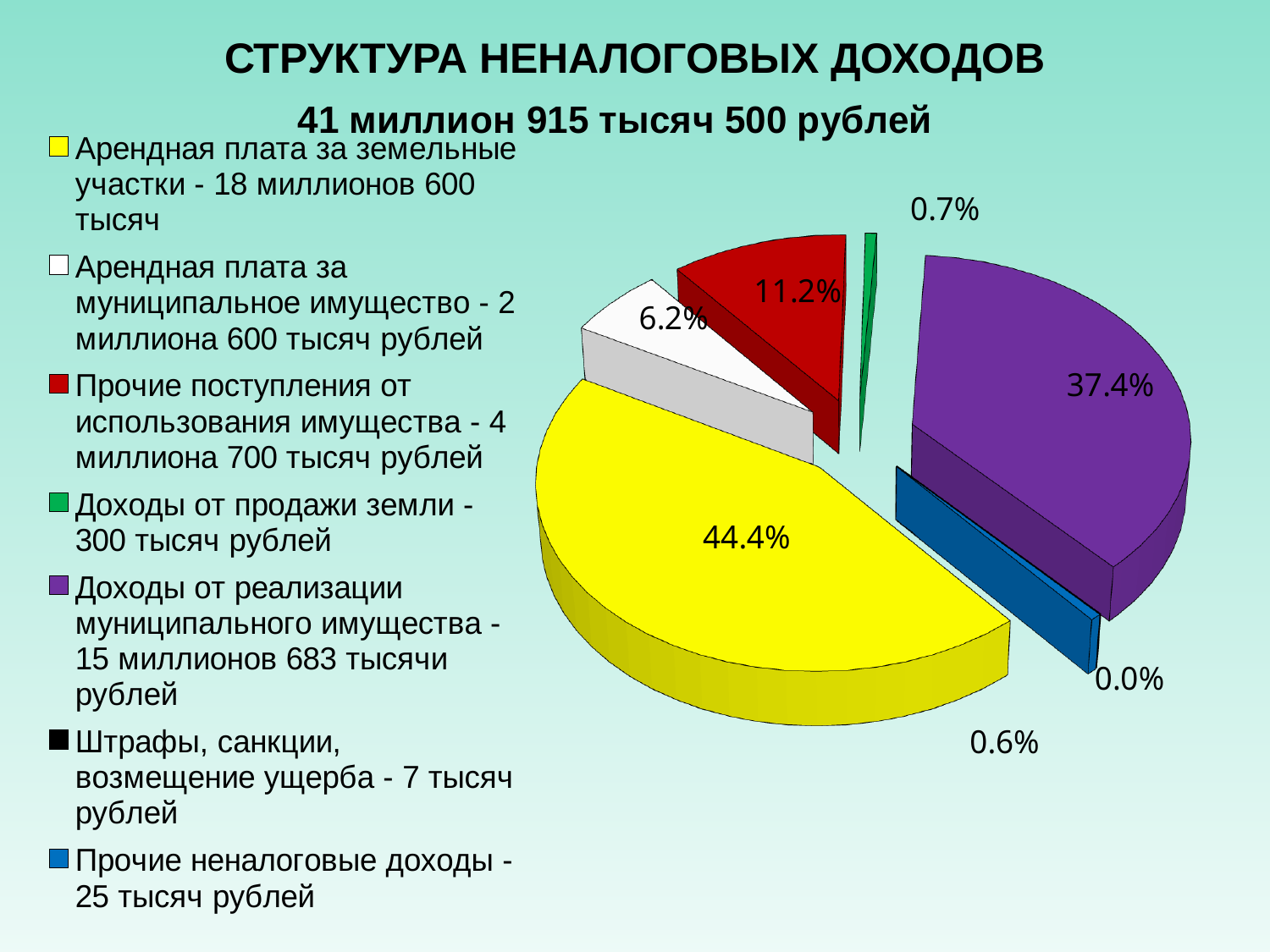
What share of the pie does 'Доходы от продажи земли' have? 0.7% What share of the pie does 'Арендная плата за муниципальное имущество' have? 6.2% What share of the pie does 'Арендная плата за земельные участки' have? 44.4% What share of the pie does 'Прочие поступления от использования имущества' have? 11.2% What colour is the slice for 'Доходы от реализации муниципального имущества'? purple What is the difference in percentage points between the 'Арендная плата за земельные участки' slice and the 'Доходы от реализации муниципального имущества' slice? 7.0% How many categories does the legend of the pie chart list? 7 What kind of chart is shown on the slide? pie chart What share of the pie does 'Доходы от реализации муниципального имущества' have? 37.4% Which category has the largest slice of the pie? Арендная плата за земельные участки Which is larger: the slice for 'Прочие поступления от использования имущества' or the slice for 'Арендная плата за муниципальное имущество'? Прочие поступления от использования имущества